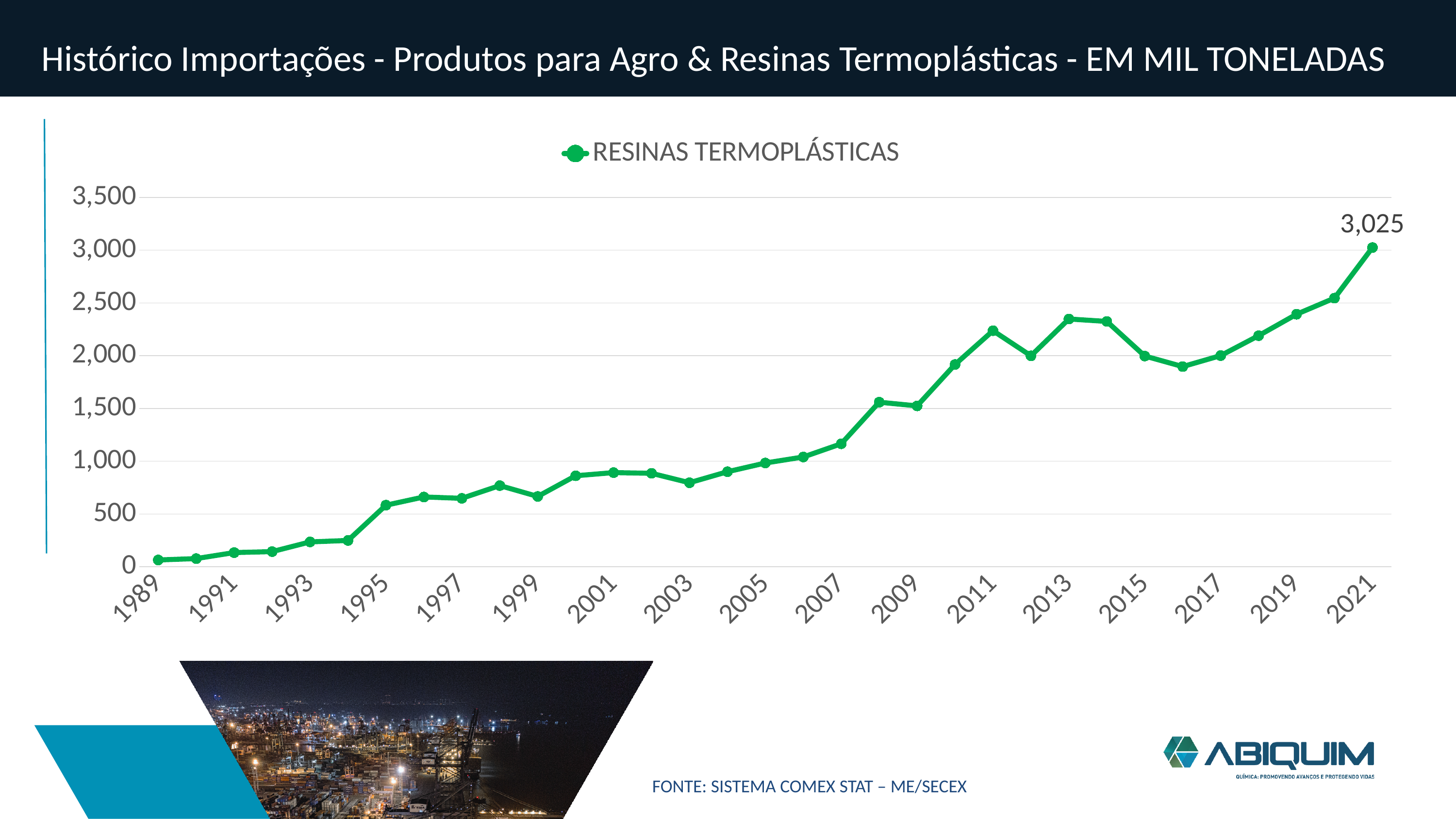
Which is larger, the value for 2001 or the value for 1993? 2001 How many series does the legend list? 1 What kind of chart is shown on the slide? line chart Is the value for 2003 greater or less than 1,000? less Do the values generally rise or fall from 1989 to 2021? rise What is the name of the series shown in the legend? RESINAS TERMOPLÁSTICAS What is the value for 2021 in the RESINAS TERMOPLÁSTICAS series? 3,025 Is the value for 2009 greater or less than 2,000? less Which is larger, the value for 2013 or the value for 2009? 2013 Which year has the highest value for RESINAS TERMOPLÁSTICAS? 2021 Is the value for 2011 greater or less than 2,000? greater